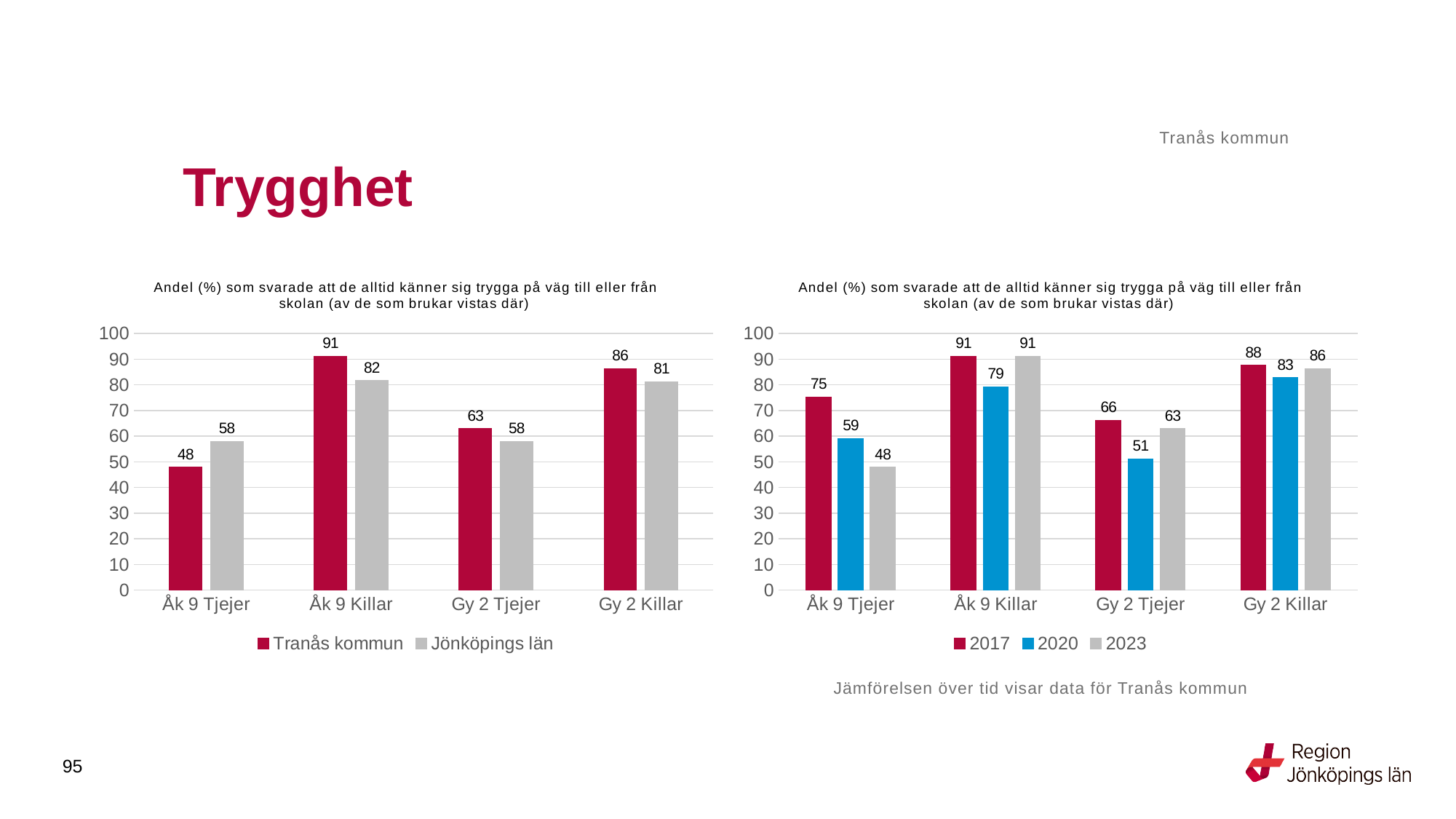
In the right chart, how many series does the legend list? 3 In the right chart, which is larger for Gy 2 Killar: the 2017 value or the 2023 value? 2017 What kind of chart is the right chart? Bar chart In the left chart, which category has the lowest value for Jönköpings län? Åk 9 Tjejer and Gy 2 Tjejer (both 58) In the right chart, what is the value for 2020 for Gy 2 Tjejer? 51 In the left chart, how many series does the legend list? 2 In the left chart, what is the difference between Tranås kommun and Jönköpings län for Åk 9 Tjejer? 10 In the left chart, what is the value for Tranås kommun for Åk 9 Tjejer? 48 In the left chart, which category has the highest value for Tranås kommun? Åk 9 Killar In the right chart, what is the value for 2023 for Åk 9 Tjejer? 48 In the right chart, what is the difference between the 2017 and 2023 values for Åk 9 Tjejer? 27 In the left chart, what is the value for Jönköpings län for Gy 2 Killar? 81